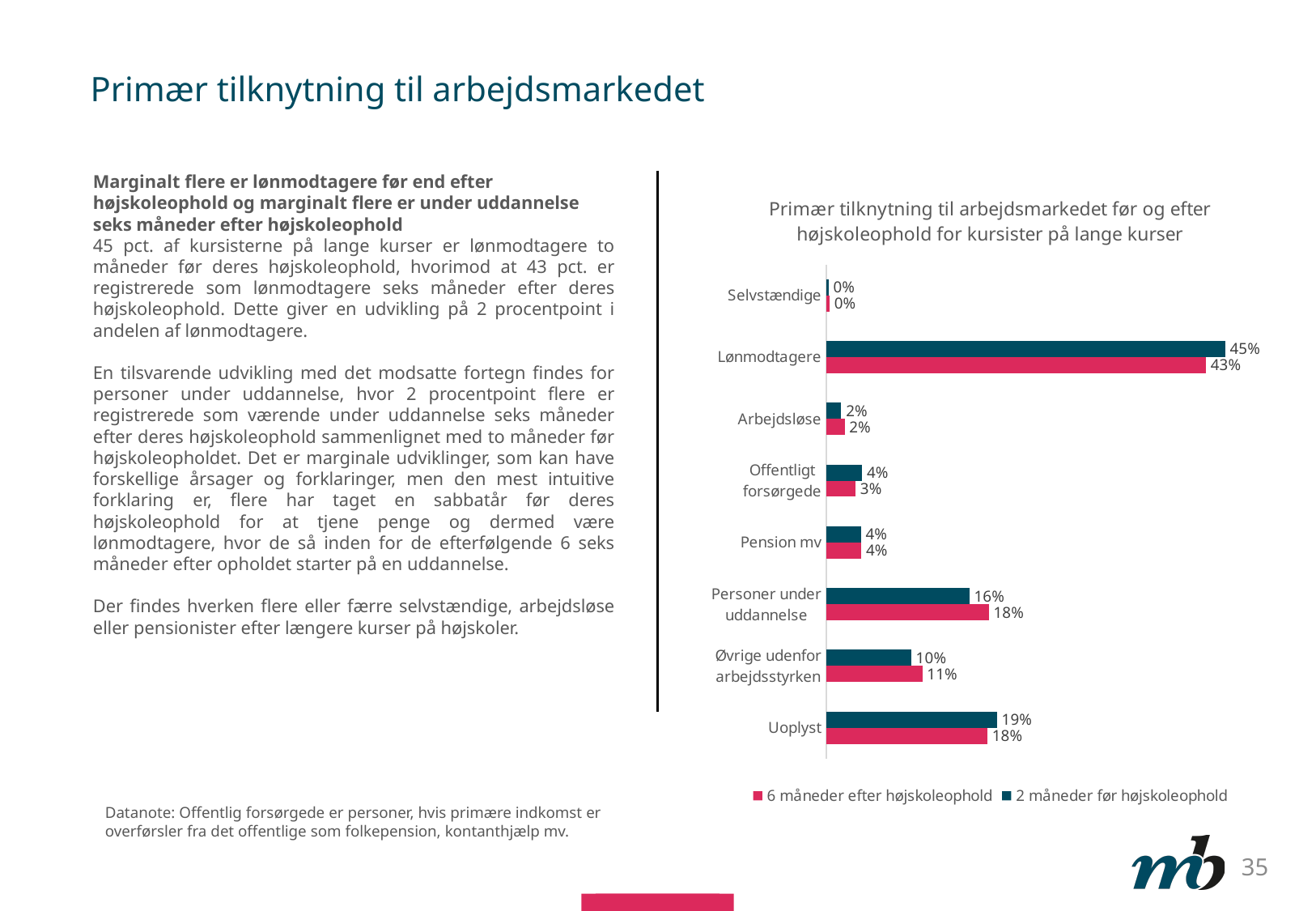
What is the value for Lønmodtagere in the series '2 måneder før højskoleophold'? 45% How many categories are shown on the chart? 8 What is the value for Uoplyst in the series '2 måneder før højskoleophold'? 19% What is the difference between the '2 måneder før højskoleophold' and '6 måneder efter højskoleophold' values for Lønmodtagere? 2 percentage points Which category has the highest value in the series '2 måneder før højskoleophold'? Lønmodtagere What type of chart is shown on the slide? bar chart For Personer under uddannelse, which series has the larger value: '2 måneder før højskoleophold' or '6 måneder efter højskoleophold'? 6 måneder efter højskoleophold What is the value for Personer under uddannelse in the series '6 måneder efter højskoleophold'? 18% Which category has the lowest value in the series '6 måneder efter højskoleophold'? Selvstændige How many series does the legend list? 2 What is the title of the chart? Primær tilknytning til arbejdsmarkedet før og efter højskoleophold for kursister på lange kurser What is the value for Øvrige udenfor arbejdsstyrken in the series '2 måneder før højskoleophold'? 10%